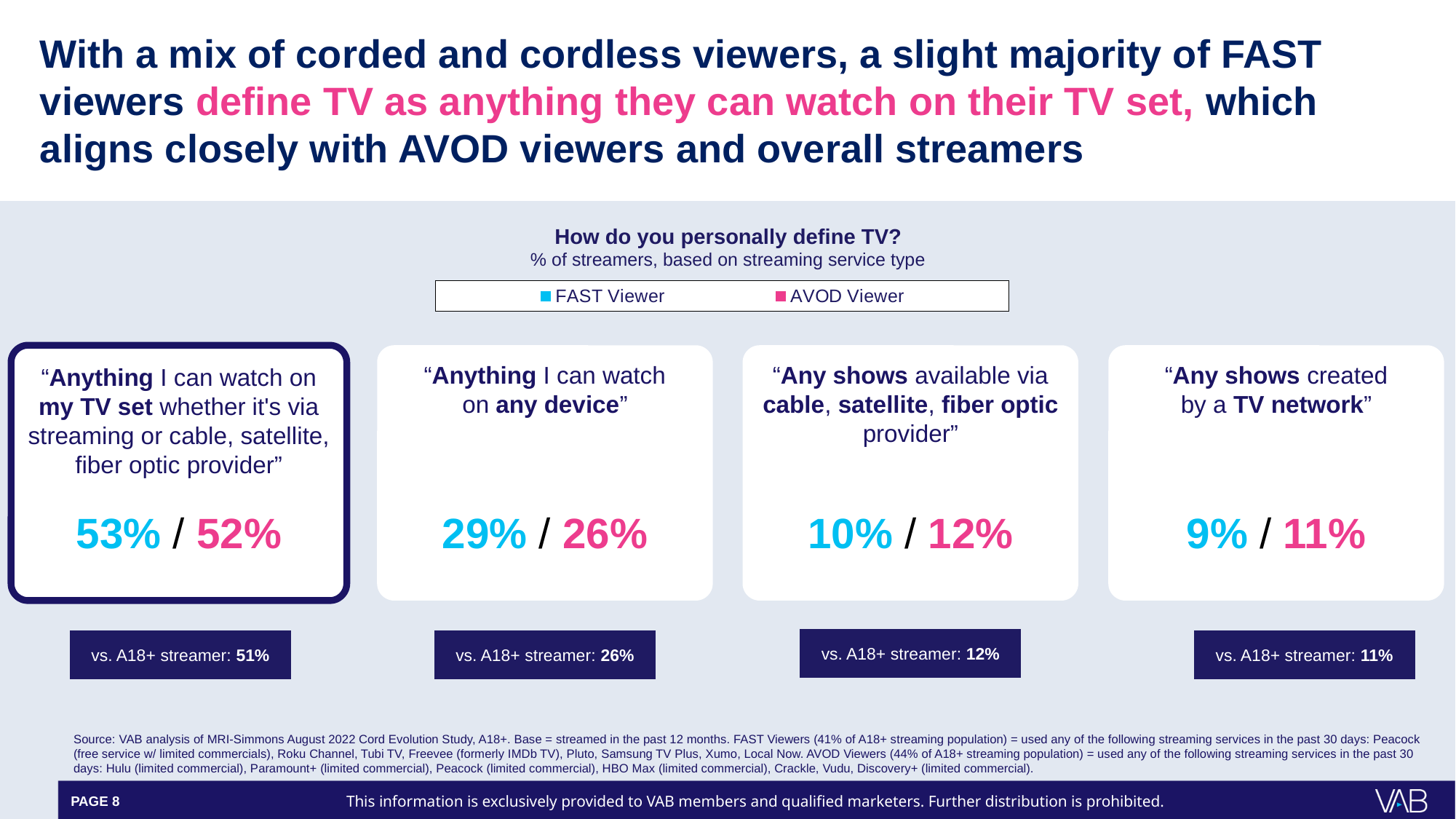
What is the difference between FAST Viewers and AVOD Viewers for "Anything I can watch on any device"? 3 percentage points What percentage of FAST Viewers define TV as "Any shows created by a TV network"? 9% What percentage of FAST Viewers define TV as "Anything I can watch on my TV set"? 53% What is the title of the chart? How do you personally define TV? Which definition of TV has the highest share among FAST Viewers? "Anything I can watch on my TV set whether it's via streaming or cable, satellite, fiber optic provider" How many viewer types does the legend list? 2 What percentage of AVOD Viewers define TV as "Anything I can watch on any device"? 26% What is the A18+ streamer comparison value for "Any shows available via cable, satellite, fiber optic provider"? 12% Which colour represents FAST Viewer in the legend? Blue For "Any shows available via cable, satellite, fiber optic provider", which is larger: the FAST Viewer or AVOD Viewer value? AVOD Viewer Which definition of TV has the lowest share among AVOD Viewers? "Any shows created by a TV network" How many definitions of TV are shown on the slide? 4